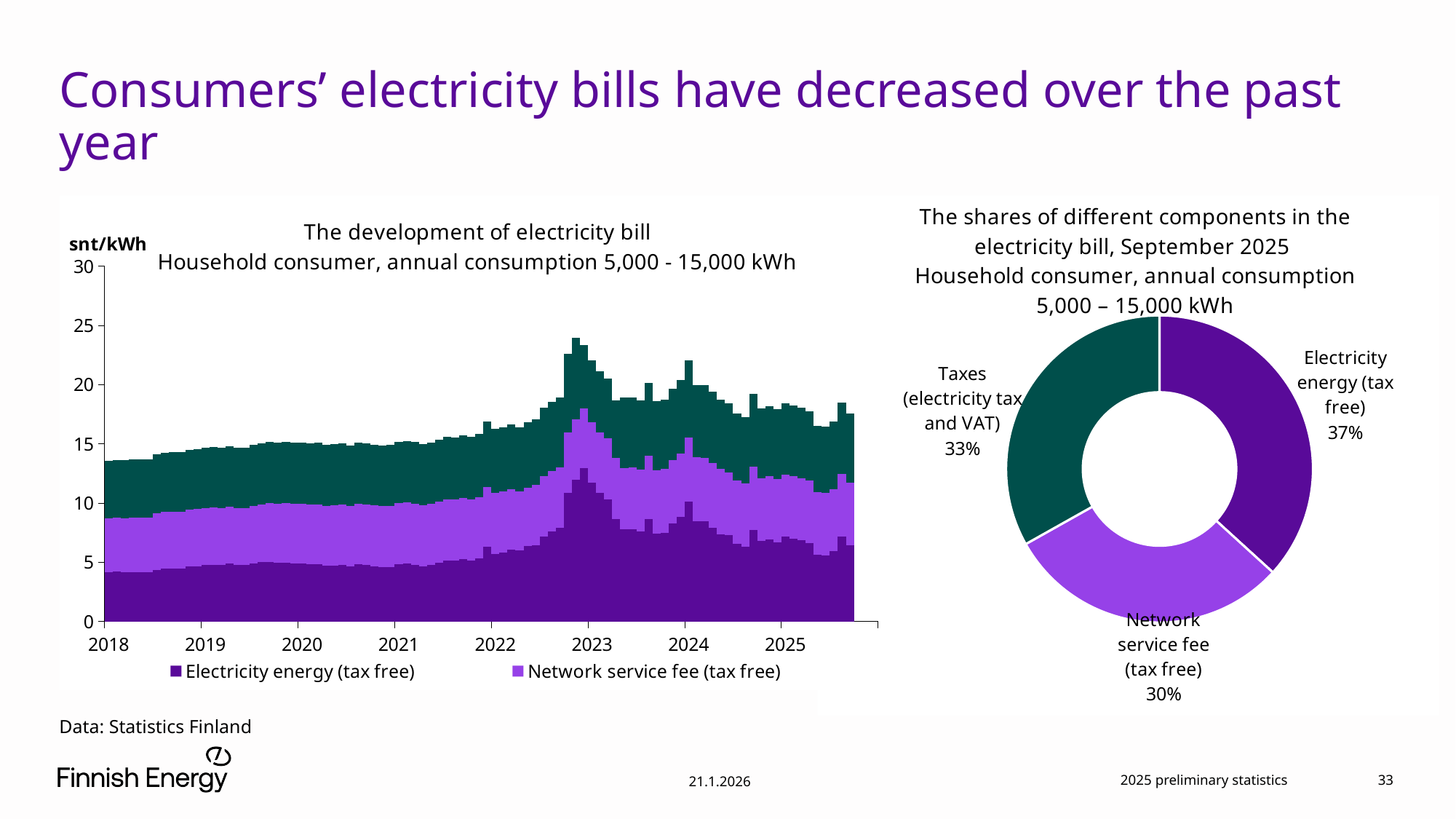
In the donut chart on the right, how many components are shown? 3 In the donut chart on the right, what is the share of Taxes (electricity tax and VAT)? 33% In the donut chart on the right, what is the share of Network service fee (tax free)? 30% In the chart on the left, how many series does the legend list? 2 What kind of chart is the chart on the right, titled 'The shares of different components in the electricity bill, September 2025'? Donut chart In the donut chart on the right, which component has the smallest share? Network service fee (tax free) What kind of chart is the chart on the left, titled 'The development of electricity bill'? Stacked bar chart In the donut chart on the right, what is the share of Electricity energy (tax free)? 37% In the chart on the left, what unit is shown on the vertical axis? snt/kWh In the donut chart on the right, how many percentage points larger is the share of Electricity energy (tax free) than the share of Taxes (electricity tax and VAT)? 4 percentage points In the chart on the left, is the total electricity bill at the start of 2018 greater or less than 15 snt/kWh? less In the donut chart on the right, which component has the largest share? Electricity energy (tax free)